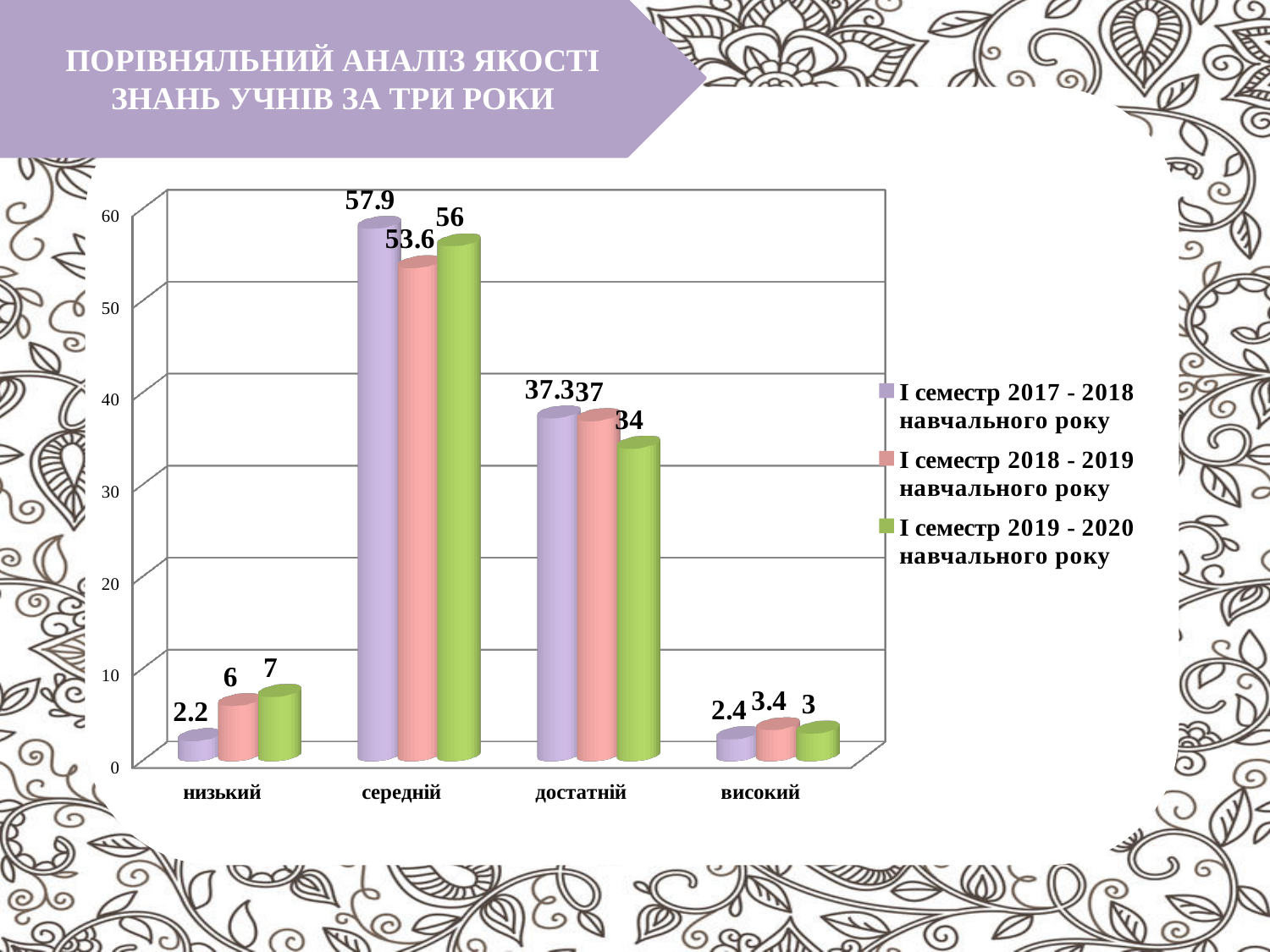
Which category has the highest value in І семестр 2018 - 2019 навчального року? середній Which is larger for достатній: І семестр 2017 - 2018 or І семестр 2019 - 2020 навчального року? І семестр 2017 - 2018 навчального року Which category has the lowest value in І семестр 2017 - 2018 навчального року? низький What kind of chart is shown on the slide? bar chart How many categories are shown on the x axis? 4 What is the value for достатній in І семестр 2019 - 2020 навчального року? 34 Which colour represents І семестр 2019 - 2020 навчального року in the legend? green What is the value for середній in І семестр 2017 - 2018 навчального року? 57.9 What is the value for високий in І семестр 2018 - 2019 навчального року? 3.4 What is the value for низький in І семестр 2019 - 2020 навчального року? 7 What is the difference between the середній values for І семестр 2017 - 2018 and І семестр 2018 - 2019 навчального року? 4.3 How many series does the legend list? 3